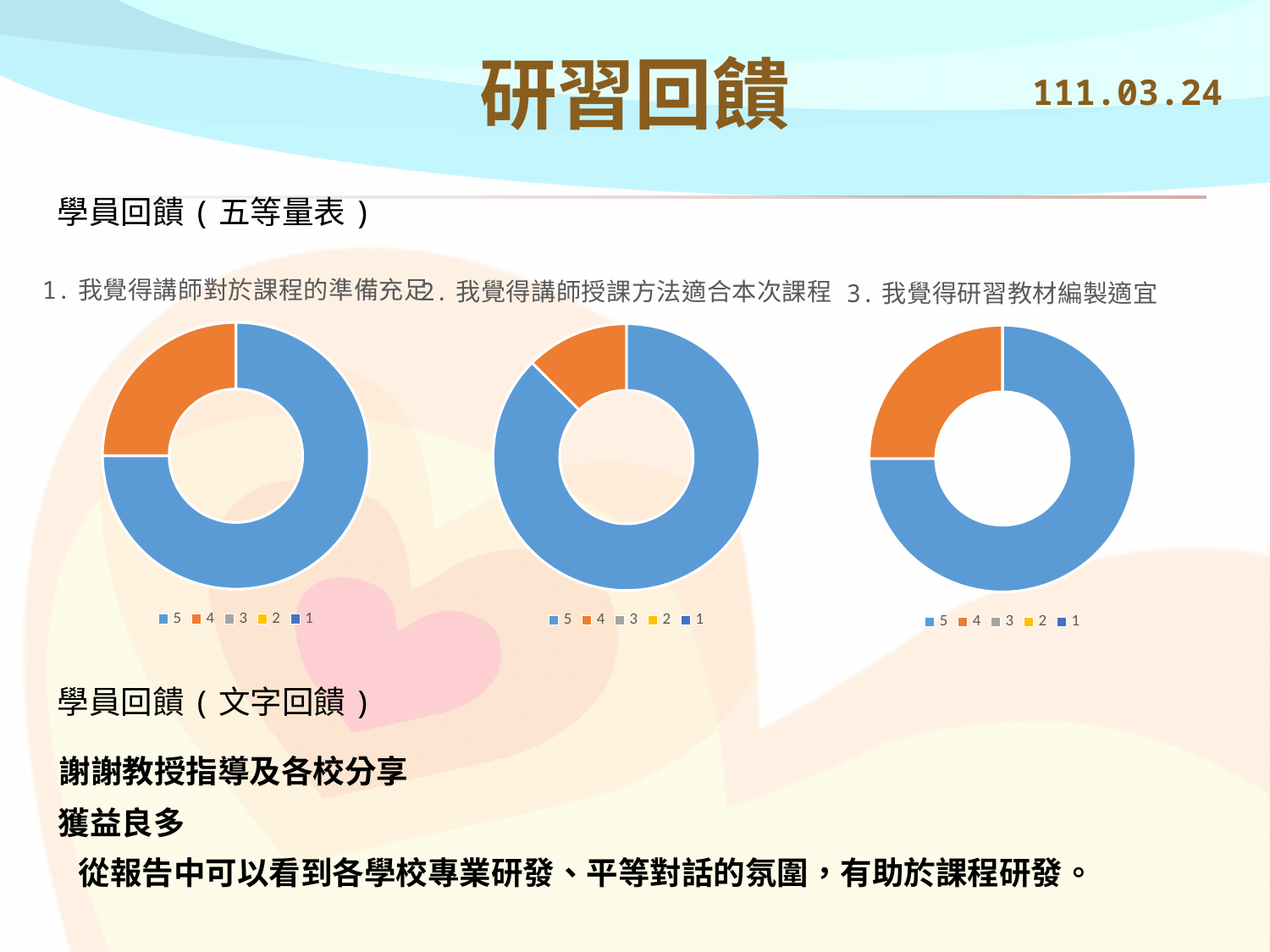
In the chart "2. 我覺得講師授課方法適合本次課程", which rating has the largest slice? 5 What kind of chart is used for "1. 我覺得講師對於課程的準備充足"? doughnut chart In the chart "1. 我覺得講師對於課程的準備充足", which is larger, the slice for rating 5 or the slice for rating 4? 5 What is the title of the rightmost chart on the slide? 3. 我覺得研習教材編製適宜 In the chart "1. 我覺得講師對於課程的準備充足", which rating has the largest slice? 5 In the chart "3. 我覺得研習教材編製適宜", which rating has the largest slice? 5 How many entries does the legend list for the chart "2. 我覺得講師授課方法適合本次課程"? 5 How many doughnut charts are shown on the slide? 3 In the chart "3. 我覺得研習教材編製適宜", which is larger, the slice for rating 4 or the slice for rating 5? 5 In the chart "2. 我覺得講師授課方法適合本次課程", what colour is the slice for rating 4? orange What is the title of the leftmost chart on the slide? 1. 我覺得講師對於課程的準備充足